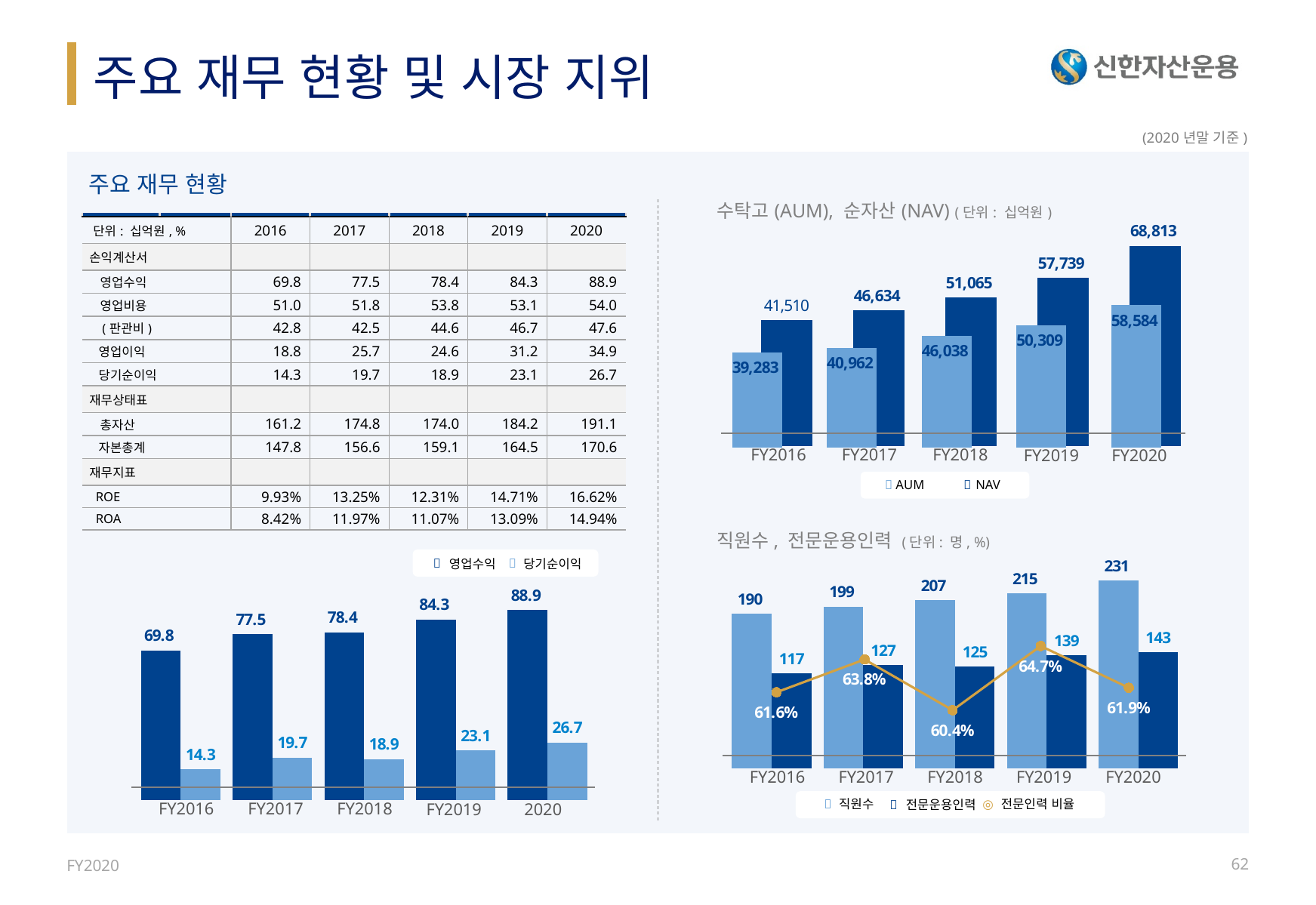
In the 직원수, 전문운용인력 chart, which is larger: 전문운용인력 in FY2017 or in FY2018? FY2017 In the 수탁고 (AUM), 순자산 (NAV) chart, which year has the highest NAV? FY2020 In the 수탁고 (AUM), 순자산 (NAV) chart, what is the NAV value for FY2018? 51,065 In the bottom-left chart (영업수익, 당기순이익), what is the difference between 영업수익 and 당기순이익 in 2020? 62.2 In the 직원수, 전문운용인력 chart, what is the 전문인력 비율 for FY2019? 64.7% In the bottom-left chart (영업수익, 당기순이익), what is the 당기순이익 value for FY2017? 19.7 In the bottom-left chart (영업수익, 당기순이익), which year has the lowest 당기순이익? FY2016 In the 직원수, 전문운용인력 chart, how many series does the legend list? 3 In the bottom-left chart (영업수익, 당기순이익), what is the 영업수익 value for FY2019? 84.3 In the 수탁고 (AUM), 순자산 (NAV) chart, what is the AUM value for FY2020? 58,584 In the 수탁고 (AUM), 순자산 (NAV) chart, does NAV rise or fall from FY2016 to FY2020? rise In the 직원수, 전문운용인력 chart, what is the 직원수 value for FY2018? 207